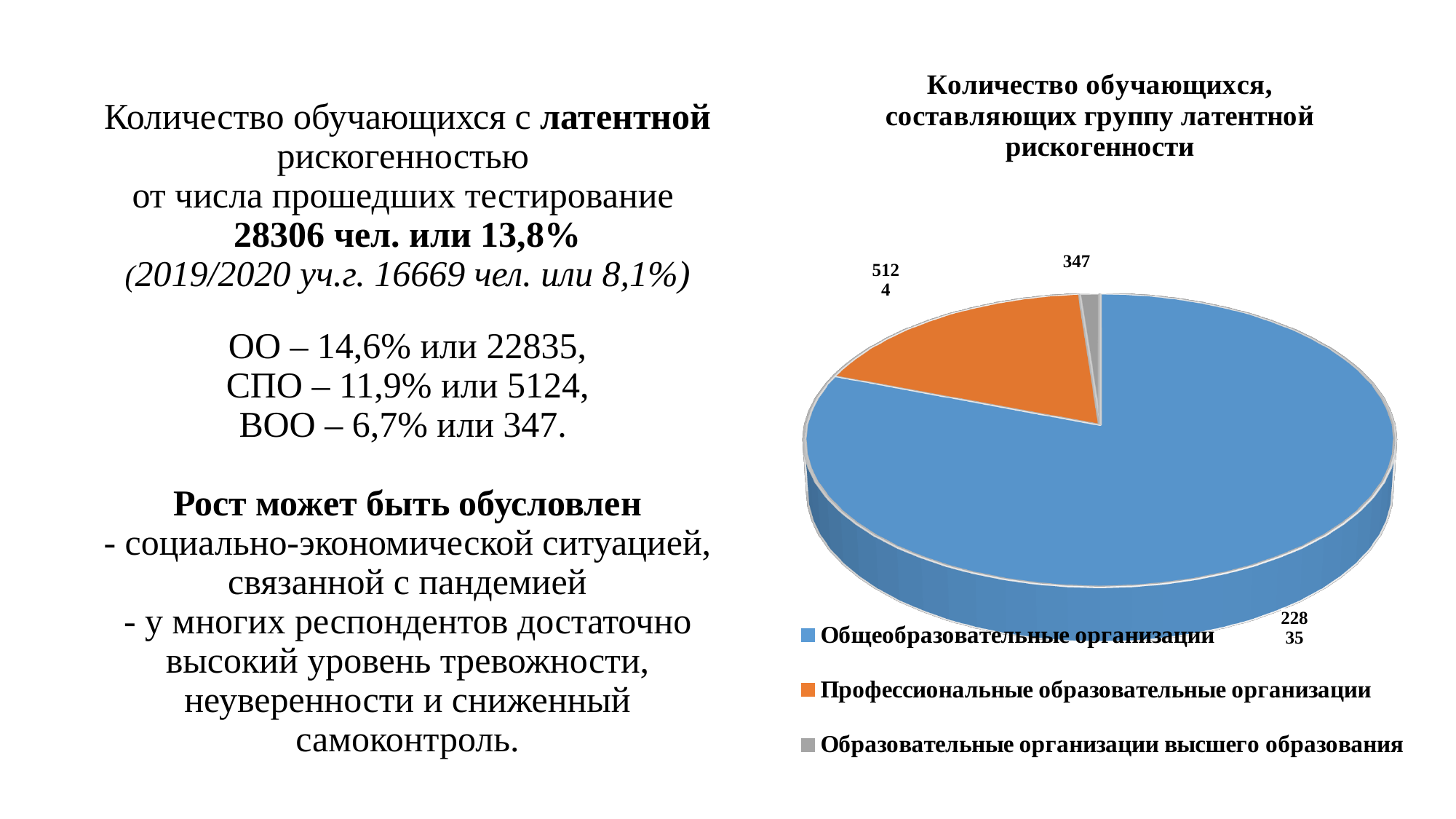
How many slices does the pie chart have? 3 Which is larger: the value for Профессиональные образовательные организации or for Образовательные организации высшего образования? Профессиональные образовательные организации What kind of chart is shown on the slide? pie chart Which category has the smallest slice in the pie chart? Образовательные организации высшего образования What is the value for Профессиональные образовательные организации in the pie chart? 5124 What is the value for Общеобразовательные организации in the pie chart? 22835 What is the difference between the values for Общеобразовательные организации and Профессиональные образовательные организации? 17711 What colour is the slice for Профессиональные образовательные организации? orange What is the title of the chart? Количество обучающихся, составляющих группу латентной рискогенности Which category has the largest slice in the pie chart? Общеобразовательные организации What is the value for Образовательные организации высшего образования in the pie chart? 347 How many entries does the chart legend list? 3